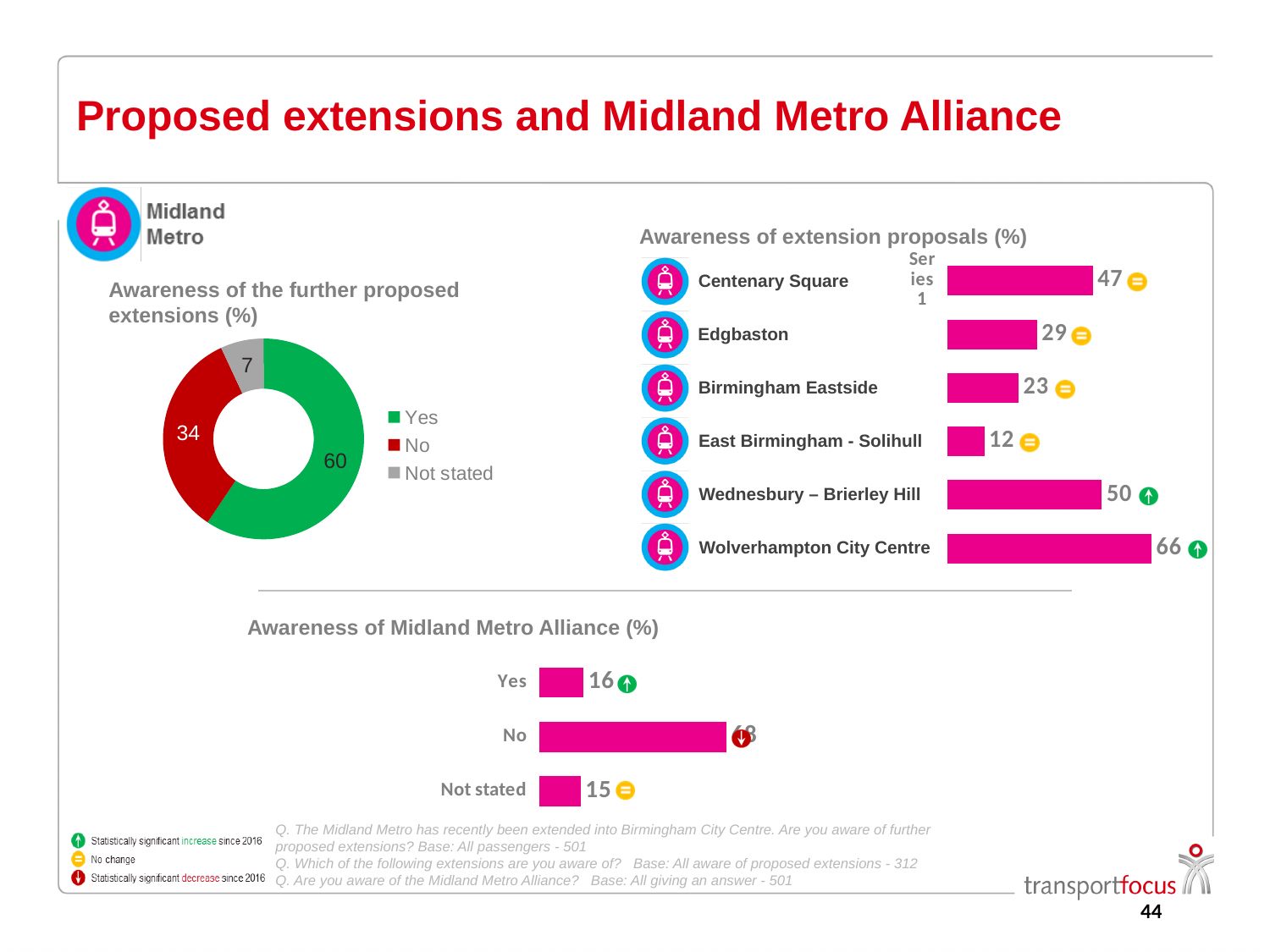
In the 'Awareness of extension proposals (%)' chart, which extension has the highest awareness? Wolverhampton City Centre In the 'Awareness of extension proposals (%)' chart, what is the difference between Wolverhampton City Centre and Edgbaston? 37 What kind of chart is 'Awareness of the further proposed extensions (%)'? Donut (pie) chart How many categories does the legend of the 'Awareness of the further proposed extensions (%)' chart list? 3 In the 'Awareness of extension proposals (%)' chart, which extension has the lowest awareness? East Birmingham - Solihull In the 'Awareness of extension proposals (%)' chart, how many extensions are listed? 6 In the 'Awareness of the further proposed extensions (%)' chart, what is the value for Not stated? 7 In the 'Awareness of the further proposed extensions (%)' chart, what percentage answered Yes? 60 In the 'Awareness of extension proposals (%)' chart, what is the value for East Birmingham - Solihull? 12 In the 'Awareness of Midland Metro Alliance (%)' chart, which is larger, Yes or Not stated? Yes In the 'Awareness of the further proposed extensions (%)' chart, what percentage answered No? 34 In the 'Awareness of extension proposals (%)' chart, what is the value for Centenary Square? 47